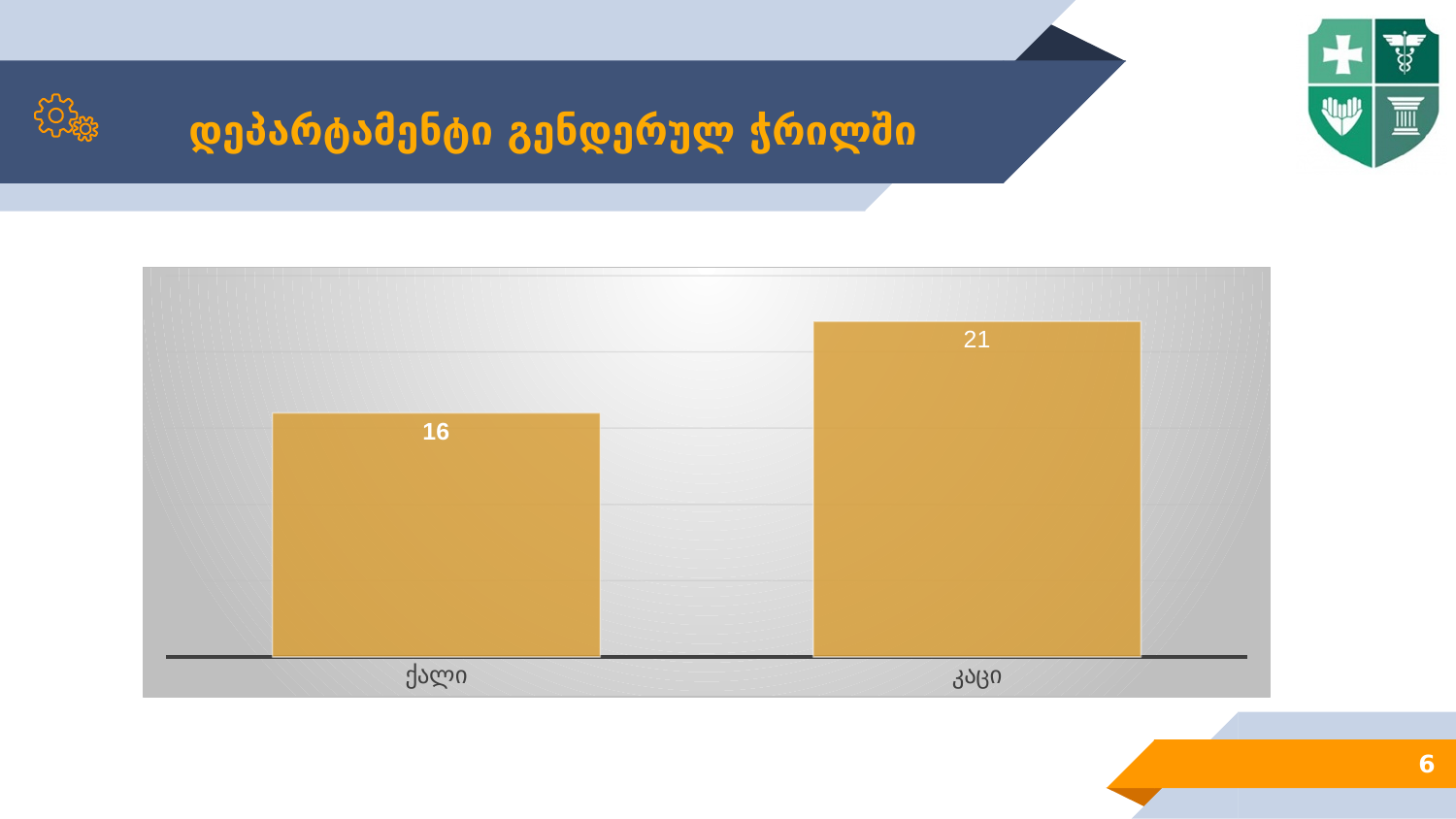
What kind of chart is shown on the slide? bar chart What is the value for კაცი? 21 Which category has the lowest value? ქალი What is the total of the two values shown in the chart? 37 What is the difference between the values for კაცი and ქალი? 5 Which category has the highest value? კაცი What colour are the bars in the chart? orange How many categories are shown in the chart? 2 What is the title of the slide containing the chart? დეპარტამენტი გენდერულ ჭრილში What is the value for ქალი? 16 Which is larger, the value for ქალი or the value for კაცი? კაცი